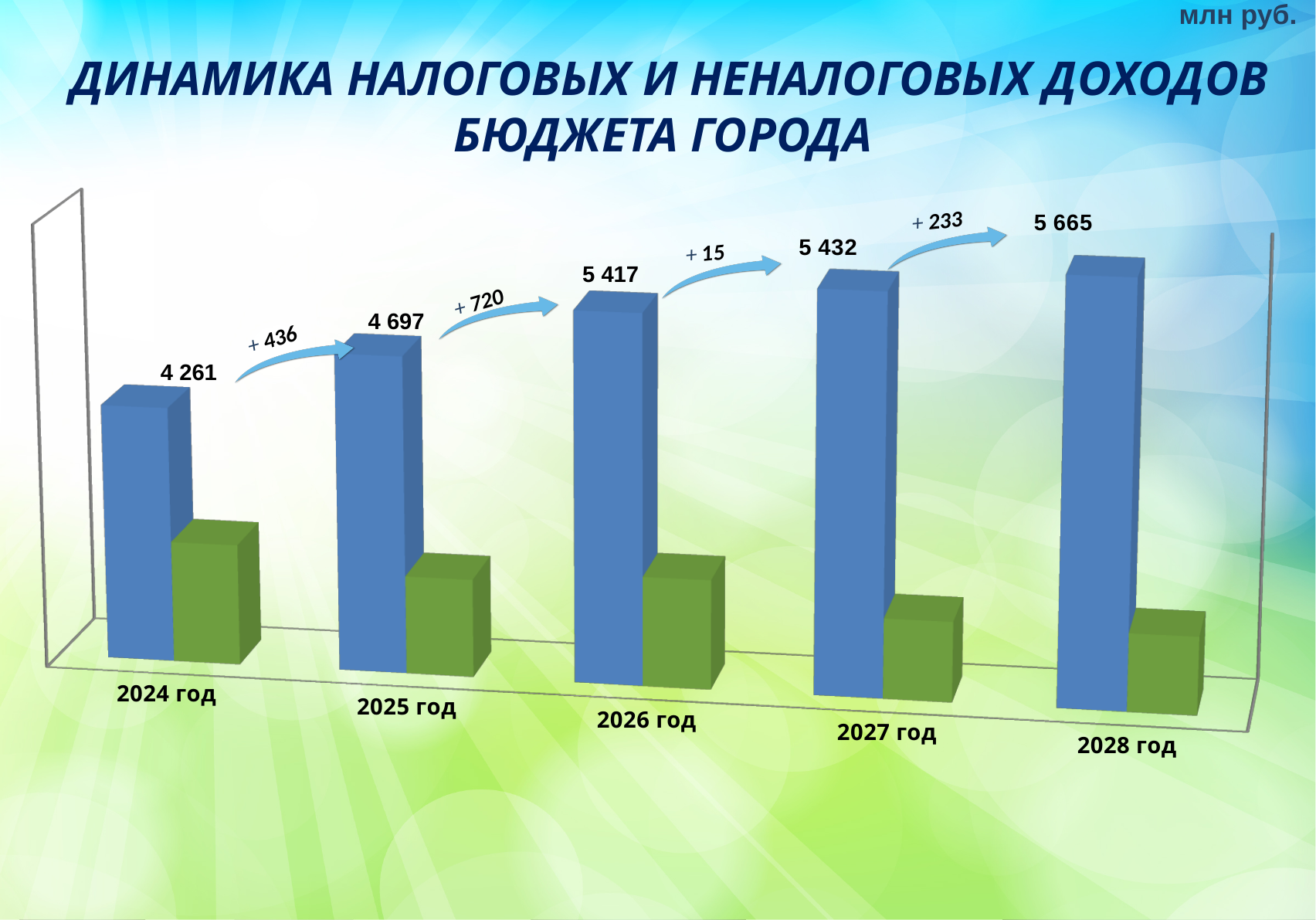
How many years are shown on the x axis of the chart? 5 Which year has the highest value for the blue bars? 2028 год Which is larger in 2025 год, the blue bar or the green bar? the blue bar Which year has the lowest value for the blue bars? 2024 год What kind of chart is shown on the slide? bar chart What unit is indicated in the top right corner of the slide? млн руб. Do the blue bar values rise or fall from 2024 год to 2028 год? rise